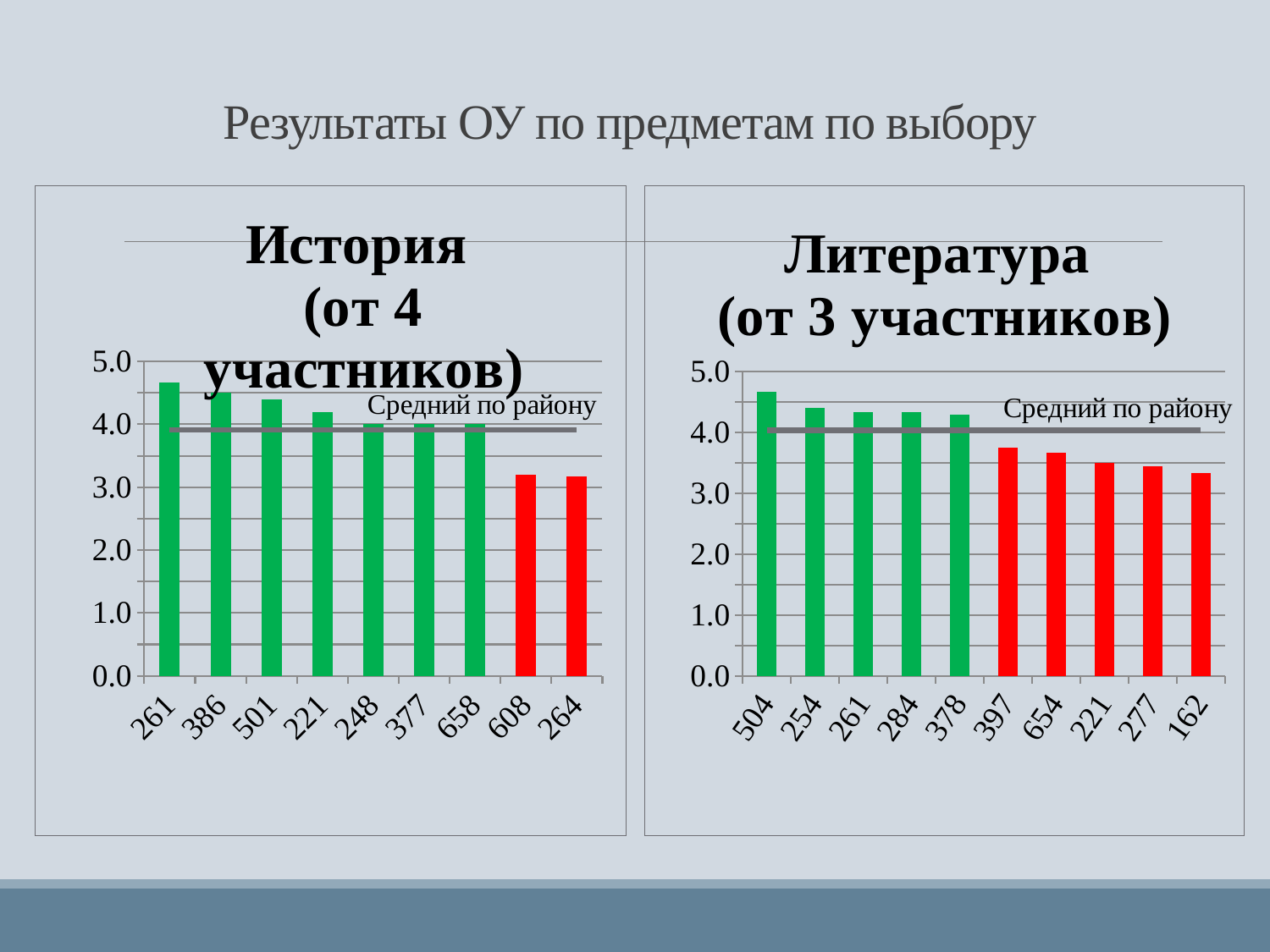
How many categories are shown on the История (от 4 участников) chart? 9 What is the label of the horizontal line drawn across both charts? Средний по району On the История (от 4 участников) chart, is the value for 608 greater or less than 4.0? less On the История (от 4 участников) chart, do the values rise or fall from left to right along the x axis? fall On the История (от 4 участников) chart, is the value for 261 greater or less than 4.0? greater On the Литература (от 3 участников) chart, which is larger, the value for 504 or the value for 654? 504 On the Литература (от 3 участников) chart, which category has the highest value? 504 On the История (от 4 участников) chart, which category has the highest value? 261 On the Литература (от 3 участников) chart, is the value for 162 greater or less than 4.0? less How many categories are shown on the Литература (от 3 участников) chart? 10 What kind of chart is the История (от 4 участников) chart? bar chart